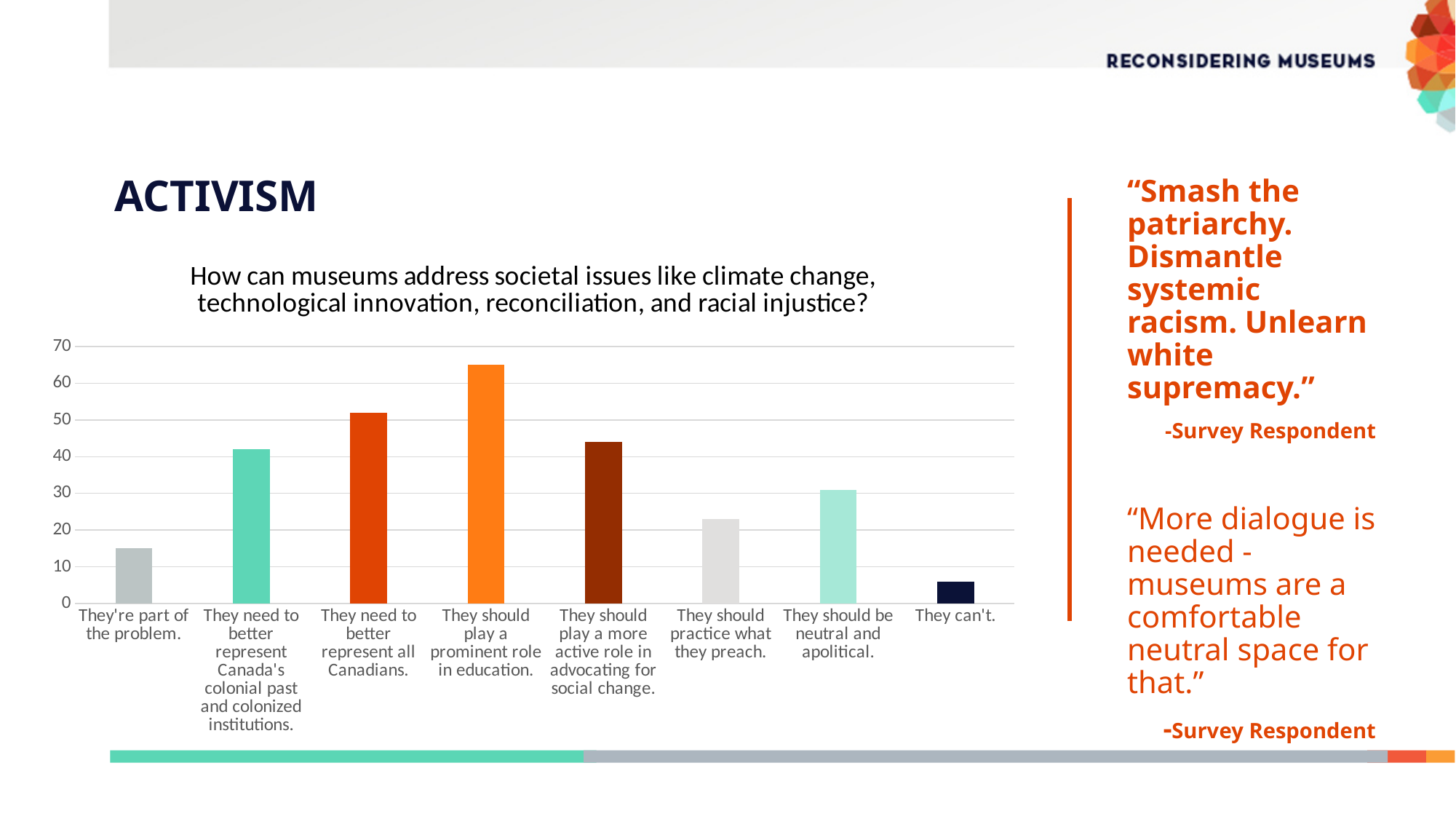
How many response categories are shown on the x axis of the chart? 8 Which is larger: the value for "They should play a prominent role in education." or the value for "They need to better represent all Canadians."? They should play a prominent role in education. Which response category has the highest bar? They should play a prominent role in education. What kind of chart is shown on the slide? bar chart Which is larger: the value for "They should be neutral and apolitical." or the value for "They should practice what they preach."? They should be neutral and apolitical. Is the value for "They should play a prominent role in education." greater or less than 60? greater What question does the chart title ask? How can museums address societal issues like climate change, technological innovation, reconciliation, and racial injustice? Is the value for "They're part of the problem." greater or less than 20? less Which response category has the lowest bar? They can't. Is the value for "They should play a more active role in advocating for social change." greater or less than 50? less